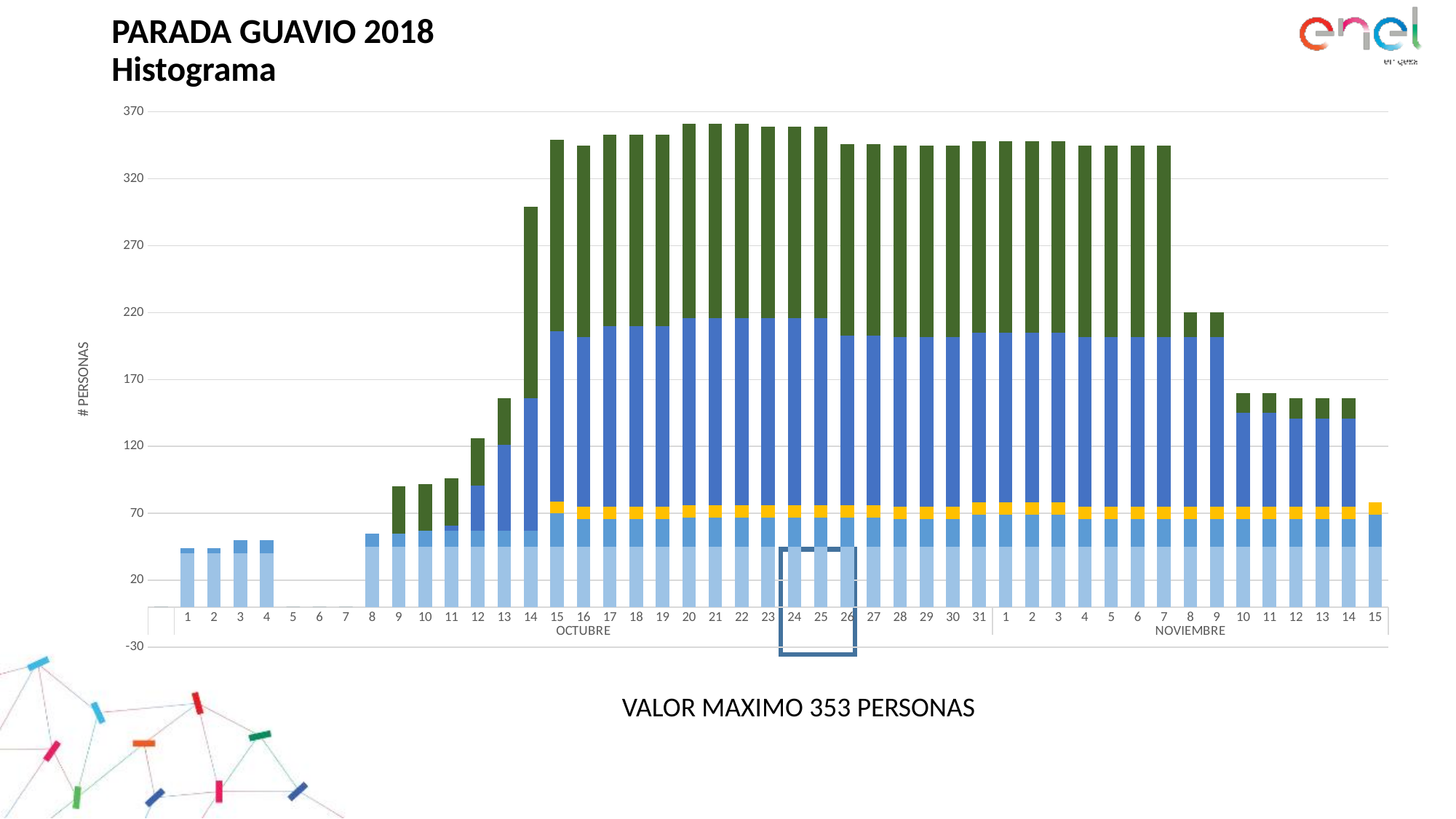
Do the total bar values rise or fall from 8 OCTUBRE to 15 OCTUBRE? rise Is the total value for 13 OCTUBRE greater or less than 120? greater Which days in OCTUBRE have no bar plotted? 5, 6 and 7 Which has the larger total bar, 9 NOVIEMBRE or 10 NOVIEMBRE? 9 NOVIEMBRE Is the total value for 12 NOVIEMBRE greater or less than 170? less Which has the larger total bar, 14 OCTUBRE or 15 OCTUBRE? 15 OCTUBRE Do the total bar values rise or fall from 7 NOVIEMBRE to 15 NOVIEMBRE? fall Is the total value for 14 OCTUBRE greater or less than 270? greater What is the label of the vertical axis? # PERSONAS What kind of chart is shown on the slide? Stacked bar chart